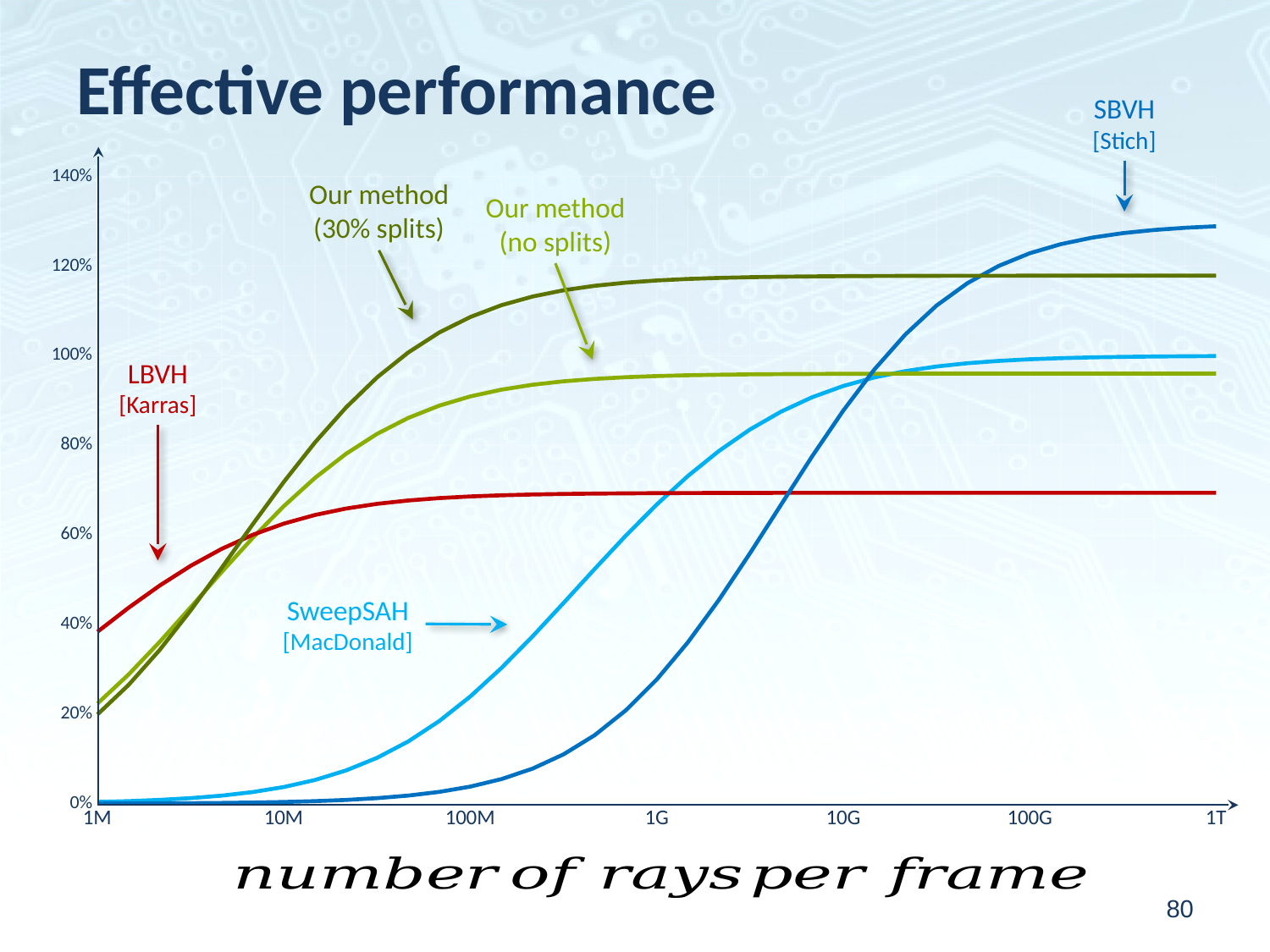
How many methods (series) are plotted on the chart? 5 What is the label of the x axis? number of rays per frame Is the value for Our method (no splits) at 1T rays per frame greater or less than 80%? greater What is the title of the chart? Effective performance Which method has the highest effective performance at 1T rays per frame? SBVH [Stich] Is the value for LBVH [Karras] at 1T rays per frame greater or less than 60%? greater Does the SBVH [Stich] curve rise or fall as the number of rays per frame increases? rise At 10M rays per frame, which is higher: LBVH [Karras] or SweepSAH [MacDonald]? LBVH [Karras] What kind of chart is shown on the slide? line chart Is the value for SBVH [Stich] at 1T rays per frame greater or less than 120%? greater Which method has the lowest effective performance at 1T rays per frame? LBVH [Karras]